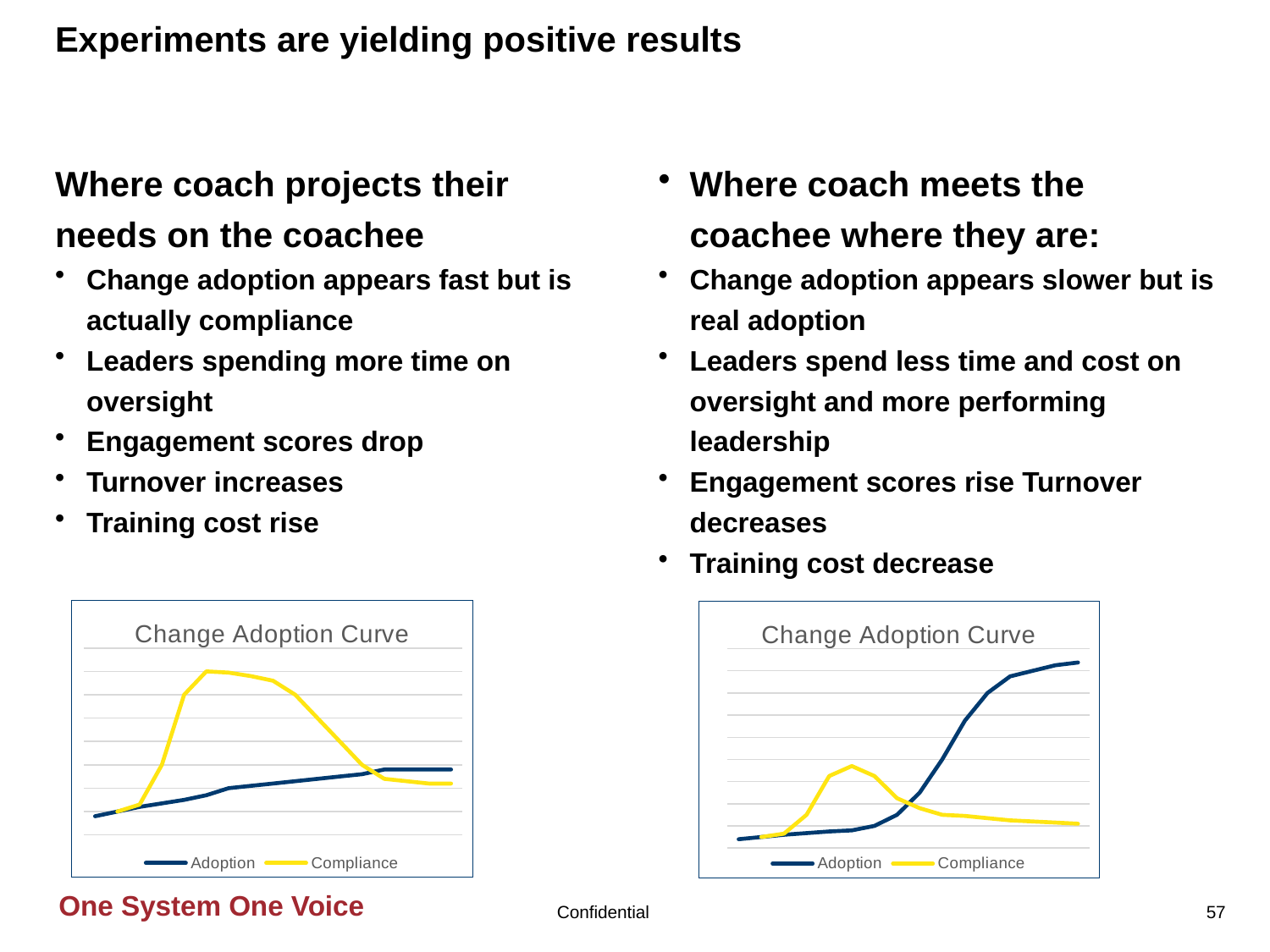
In the right chart, which series ends higher at the right end of the x axis, Adoption or Compliance? Adoption In the right chart, which series reaches the higher peak, Adoption or Compliance? Adoption How many series does the legend of the left chart list? 2 In the right chart, does the Compliance line rise or fall over the second half of the x axis? fall In the left chart, does the Adoption line generally rise or fall along the x axis? rise What kind of chart is the chart on the left of the slide? line chart What is the title of the chart on the left of the slide? Change Adoption Curve In the right chart, does the Adoption line generally rise or fall along the x axis? rise How many series does the legend of the right chart list? 2 What kind of chart is the chart on the right of the slide? line chart In the left chart, which series is drawn in yellow? Compliance In the left chart, which series reaches the higher peak, Adoption or Compliance? Compliance